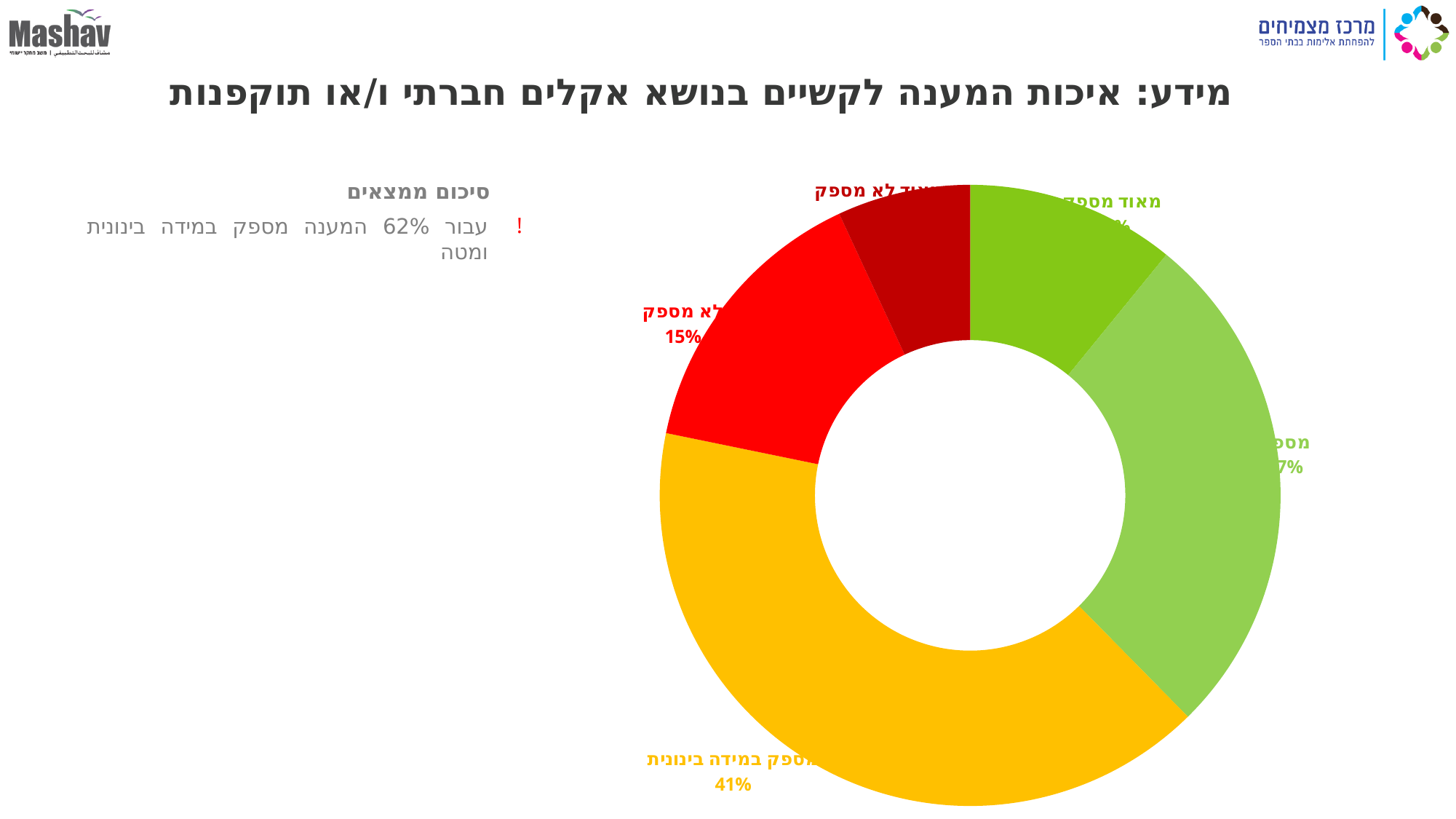
What percentage is shown for the slice labelled מספק במידה בינונית? 41% What percentage is shown for the slice labelled לא מספק? 15% Which slice of the donut chart is the smallest? מאוד לא מספק What colour is the slice labelled מספק במידה בינונית? Yellow What is the combined share of the מספק במידה בינונית (41%) and לא מספק (15%) slices? 56% How many slices does the donut chart have? 5 Which is larger, the slice for מספק במידה בינונית or the slice for לא מספק? מספק במידה בינונית Which is larger, the slice for מספק or the slice for לא מספק? מספק What kind of chart is shown on the slide? Pie (donut) chart What is the difference in percentage points between the מספק במידה בינונית slice (41%) and the לא מספק slice (15%)? 26 percentage points Which slice of the donut chart is the largest? מספק במידה בינונית What is the title of the slide containing the chart? מידע: איכות המענה לקשיים בנושא אקלים חברתי ו/או תוקפנות